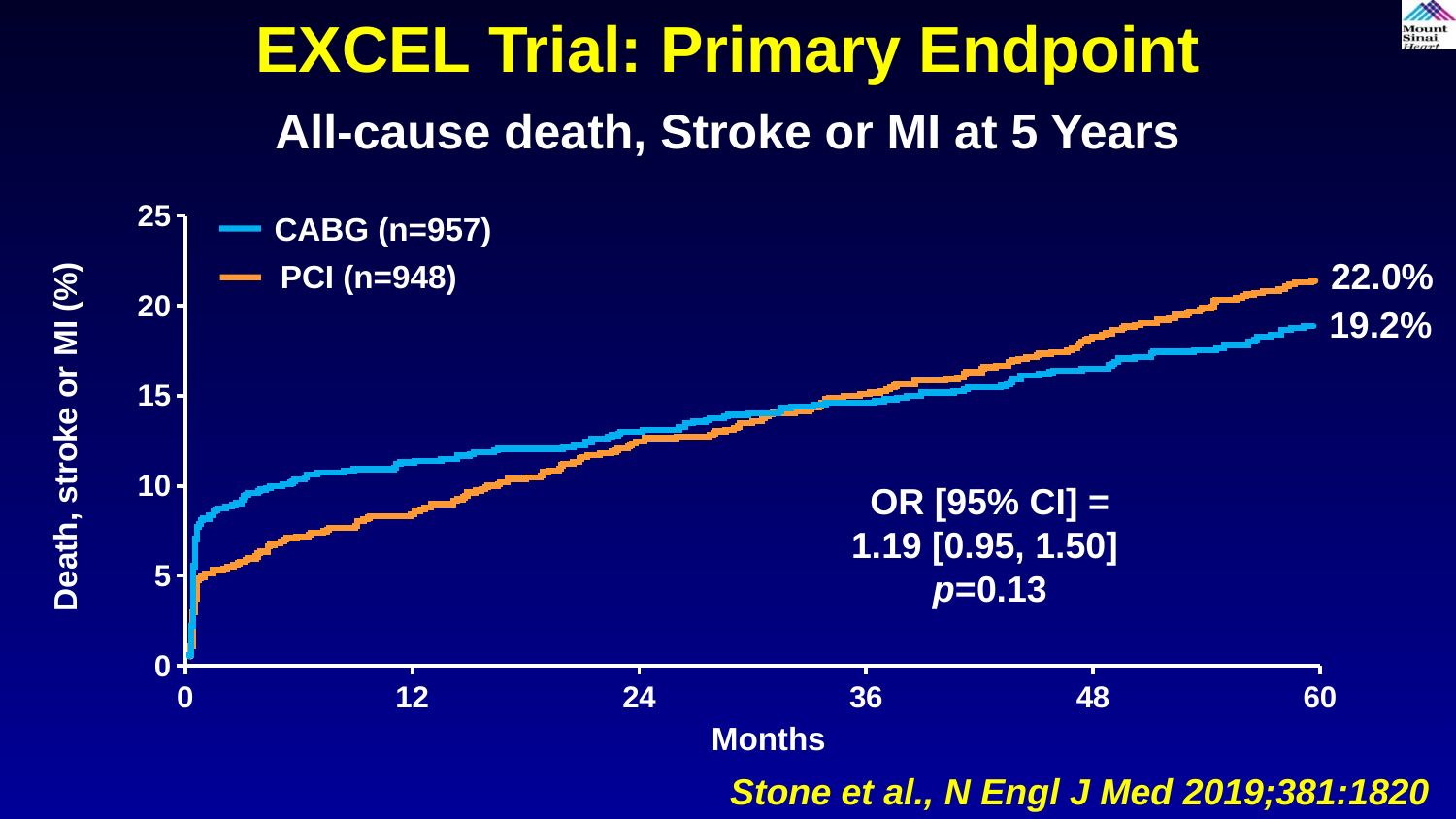
What is the difference between the PCI and CABG values at 60 months? 2.8% Is the value for CABG at 12 months greater or less than 10? greater Do the values for PCI rise or fall as months increase? Rise Which series has the higher value at 60 months, CABG or PCI? PCI Is the value for PCI at 12 months greater or less than 10? less What is the value for CABG at 60 months? 19.2% Which series has the higher value at 12 months, CABG or PCI? CABG What kind of chart is shown on the slide? Line chart Is the value for PCI at 48 months greater or less than 15? greater What is the value for PCI at 60 months? 22.0% How many series does the legend list? 2 What is the label of the y axis? Death, stroke or MI (%)